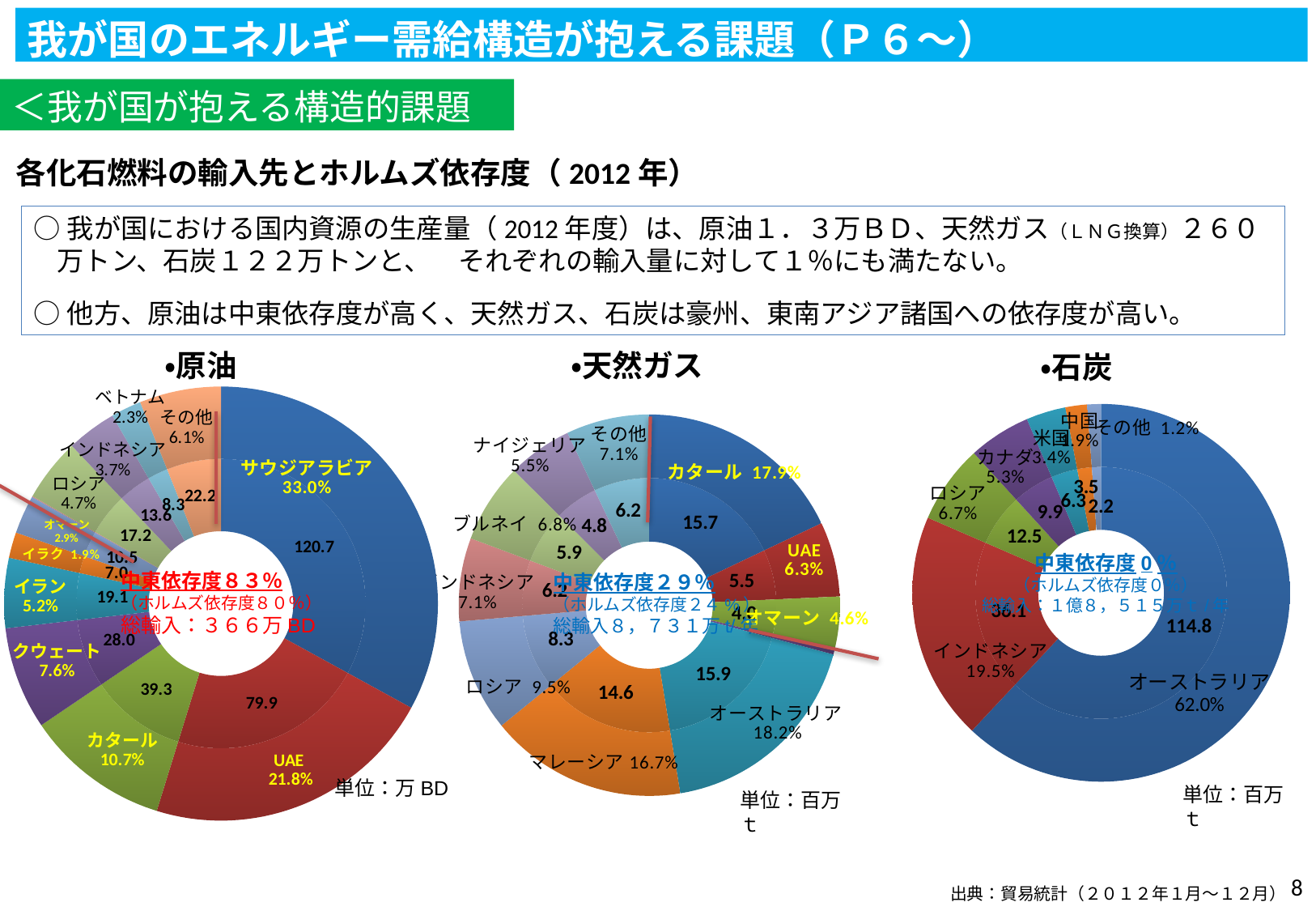
In the 石炭 chart, which country has the smallest share of coal imports (excluding その他)? 中国 What kind of chart is used for the 原油 (crude oil) chart on the left? Doughnut (pie) chart What is the 中東依存度 (Middle East dependence) shown in the centre of the 原油 chart? 83% In the 石炭 chart, what share of coal imports comes from オーストラリア? 62.0% In the 原油 chart, what is the import volume from UAE in 万BD? 79.9 In the 原油 chart, which country has the largest share of crude oil imports? サウジアラビア In the 天然ガス chart, what is the import volume from ロシア in 百万t? 8.3 In the 原油 chart, what is the difference in share between サウジアラビア and UAE? 11.2% In the 石炭 chart, what is the difference in share between オーストラリア and インドネシア? 42.5% In the 天然ガス chart, what share of natural gas imports comes from オーストラリア? 18.2% In the 原油 chart, what share of crude oil imports comes from サウジアラビア? 33.0% In the 天然ガス chart, which is larger, the share for カタール or the share for マレーシア? カタール